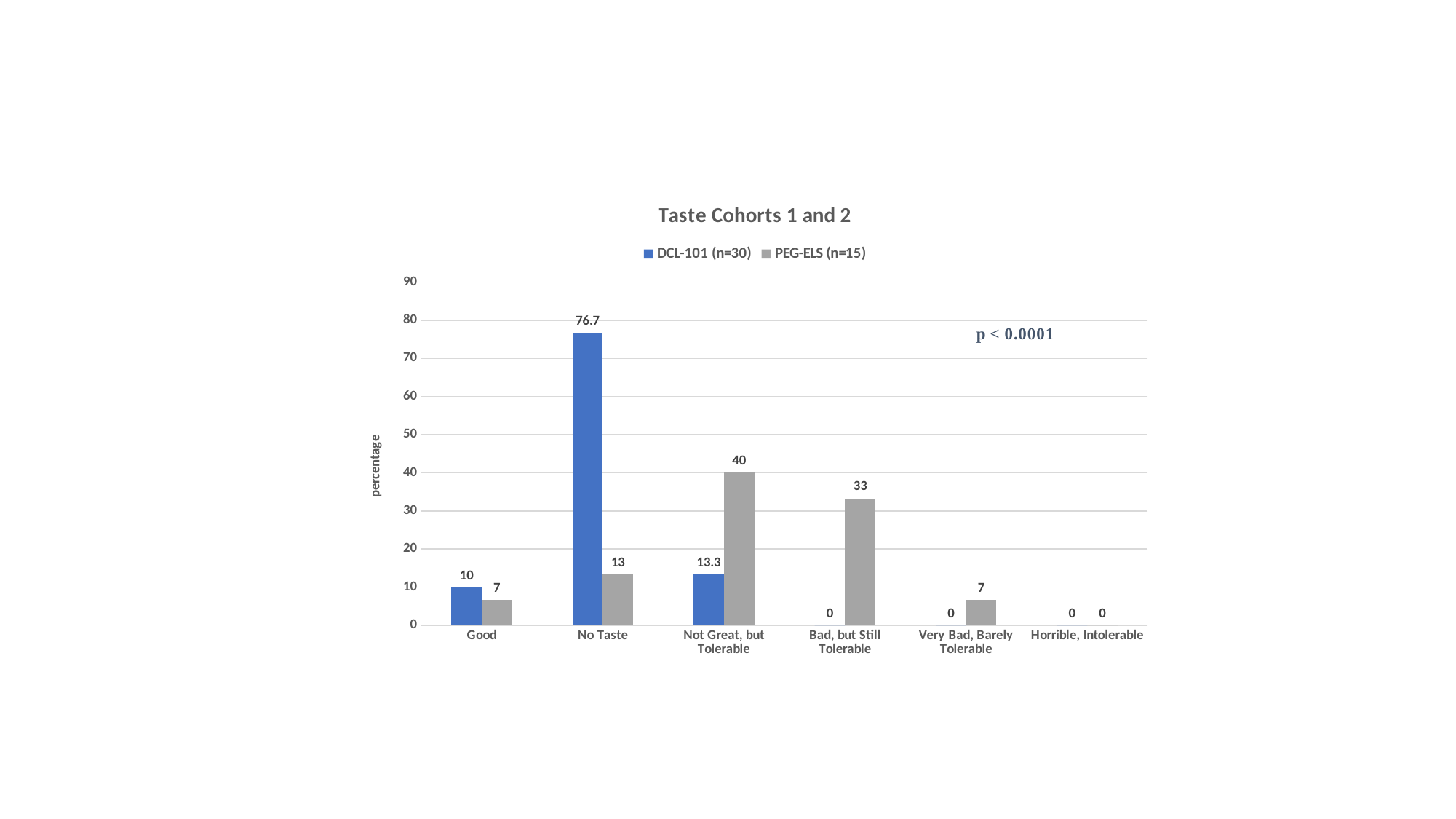
What is the value for DCL-101 (n=30) in the No Taste category? 76.7 What is the value for DCL-101 (n=30) in the Good category? 10 How many categories are shown on the x axis? 6 Which category has the highest value for PEG-ELS (n=15)? Not Great, but Tolerable What is the value for PEG-ELS (n=15) in the Not Great, but Tolerable category? 40 What is the difference between the DCL-101 (n=30) and PEG-ELS (n=15) values in the No Taste category? 63.7 What kind of chart is shown on the slide? Bar chart In the Not Great, but Tolerable category, which series has the larger value, DCL-101 (n=30) or PEG-ELS (n=15)? PEG-ELS (n=15) Which category has the highest value for DCL-101 (n=30)? No Taste What is the value for PEG-ELS (n=15) in the Bad, but Still Tolerable category? 33 How many series does the legend list? 2 What is the title of the chart? Taste Cohorts 1 and 2